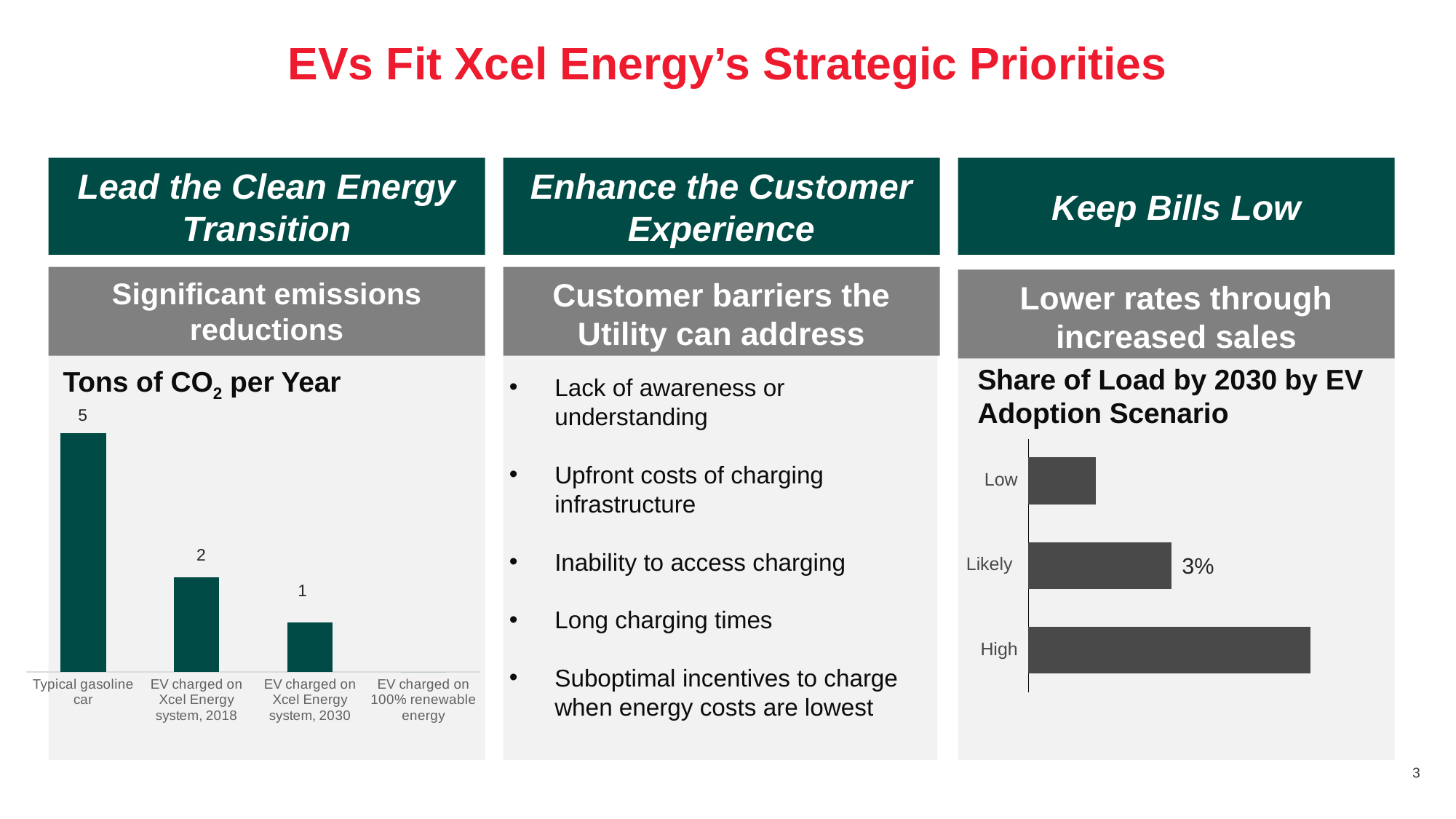
In the 'Tons of CO2 per Year' chart, do the values rise or fall from left to right? Fall How many categories are shown on the x axis of the 'Tons of CO2 per Year' chart? 4 In the 'Tons of CO2 per Year' chart, which is larger: the value for an EV charged on the Xcel Energy system in 2018 or in 2030? EV charged on Xcel Energy system, 2018 In the 'Tons of CO2 per Year' chart, which category has the highest value? Typical gasoline car In the 'Tons of CO2 per Year' chart, what is the difference between a typical gasoline car and an EV charged on the Xcel Energy system in 2018? 3 In the 'Share of Load by 2030 by EV Adoption Scenario' chart, what is the value for the Likely scenario? 3% In the 'Tons of CO2 per Year' chart, what is the value for an EV charged on the Xcel Energy system in 2018? 2 What kind of chart is the 'Tons of CO2 per Year' chart? Bar chart In the 'Tons of CO2 per Year' chart, what is the value for a typical gasoline car? 5 How many scenarios are shown in the 'Share of Load by 2030 by EV Adoption Scenario' chart? 3 In the 'Tons of CO2 per Year' chart, what is the value for an EV charged on the Xcel Energy system in 2030? 1 In the 'Share of Load by 2030 by EV Adoption Scenario' chart, which scenario has the highest share of load? High